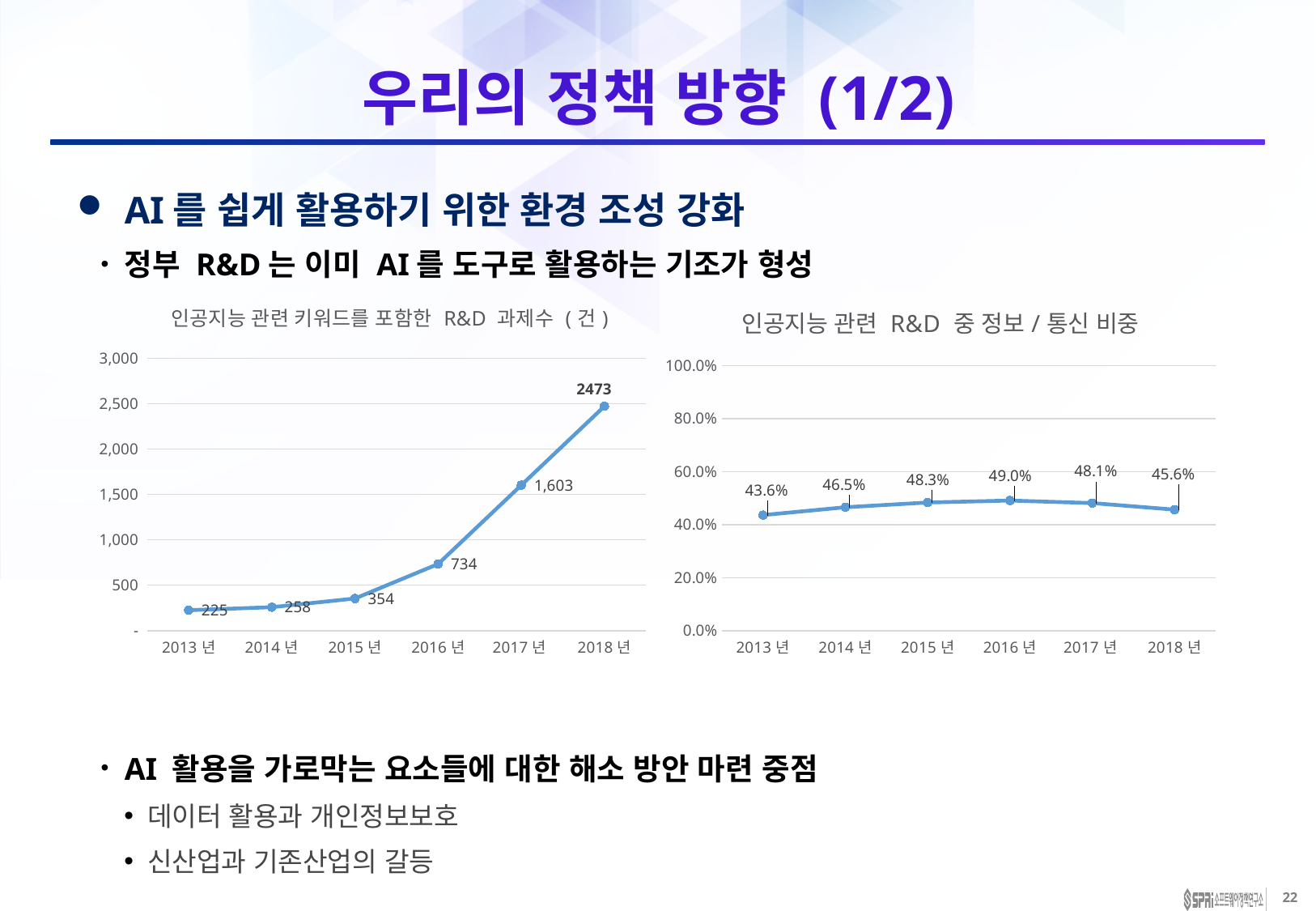
In the left chart (인공지능 관련 키워드를 포함한 R&D 과제수), do the values rise or fall from 2013년 to 2018년? rise In the right chart (인공지능 관련 R&D 중 정보/통신 비중), which year has the highest value? 2016년 In the left chart (인공지능 관련 키워드를 포함한 R&D 과제수), what is the value for 2015년? 354 In the left chart (인공지능 관련 키워드를 포함한 R&D 과제수), what is the difference between the values for 2017년 and 2016년? 869 What kind of chart is the right chart (인공지능 관련 R&D 중 정보/통신 비중)? line chart In the right chart (인공지능 관련 R&D 중 정보/통신 비중), is the value for 2013년 greater or less than 40.0%? greater In the right chart (인공지능 관련 R&D 중 정보/통신 비중), what is the value for 2016년? 49.0% In the left chart (인공지능 관련 키워드를 포함한 R&D 과제수), what is the value for 2018년? 2473 What is the title of the left chart? 인공지능 관련 키워드를 포함한 R&D 과제수 (건) In the left chart (인공지능 관련 키워드를 포함한 R&D 과제수), how many years are plotted? 6 In the left chart (인공지능 관련 키워드를 포함한 R&D 과제수), which year has the lowest value? 2013년 In the right chart (인공지능 관련 R&D 중 정보/통신 비중), which is larger, the value for 2014년 or 2018년? 2014년